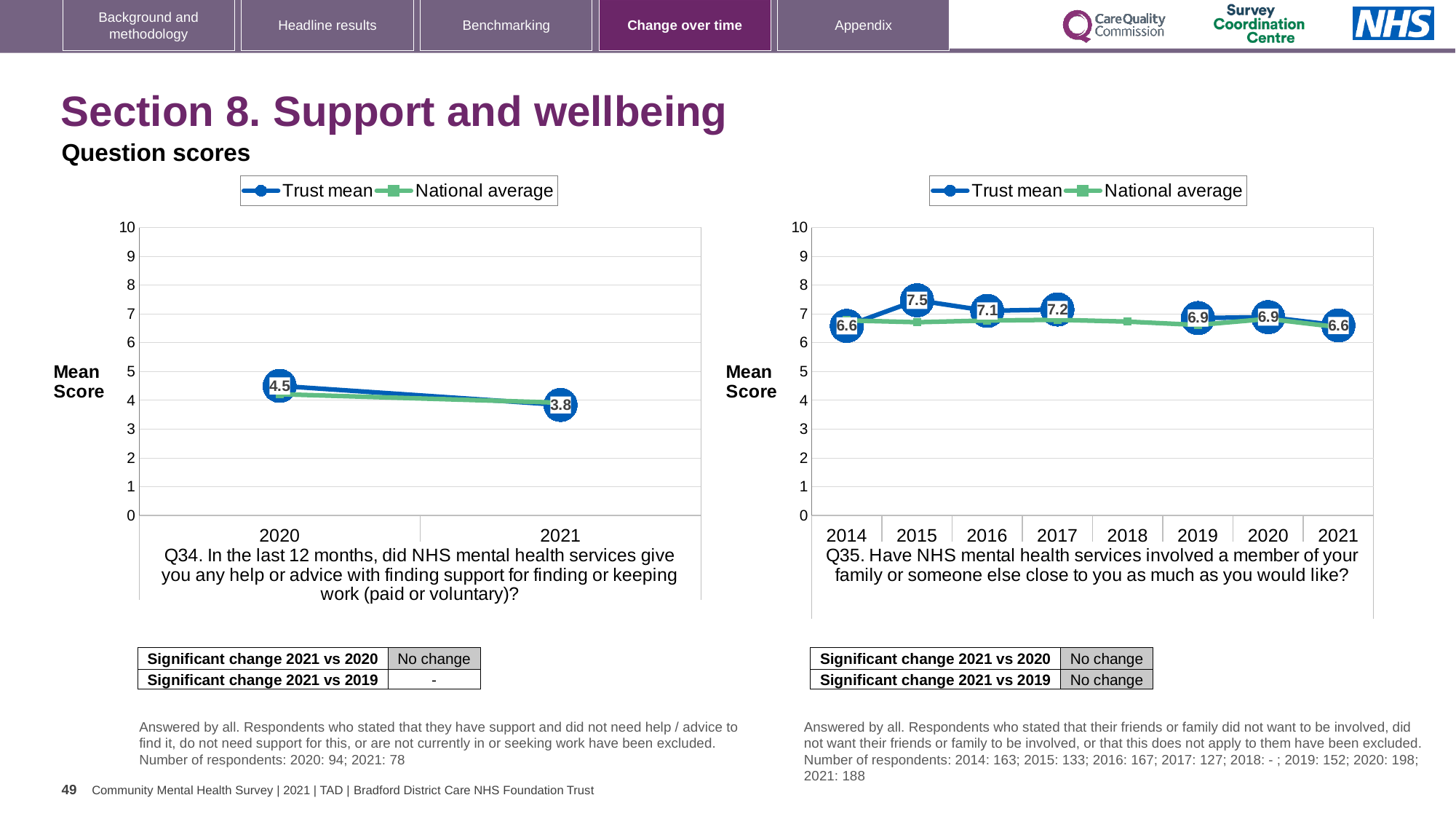
How many series does the legend of the left chart list? 2 What type of chart is the right chart (Q35)? line chart In the right chart (Q35), which year has the highest Trust mean? 2015 In the right chart (Q35), what is the difference between the Trust mean in 2015 and in 2016? 0.4 In the right chart (Q35), is the Trust mean for 2017 greater or less than 7? greater In the right chart (Q35), how many years are shown on the x axis? 8 In the left chart (Q34), what is the Trust mean for 2021? 3.8 In the left chart (Q34), does the Trust mean rise or fall from 2020 to 2021? fall In the left chart (Q34), by how much did the Trust mean change from 2020 to 2021? 0.7 In the right chart (Q35), what is the Trust mean for 2015? 7.5 In the right chart (Q35), what is the Trust mean for 2021? 6.6 In the left chart (Q34), what is the Trust mean for 2020? 4.5